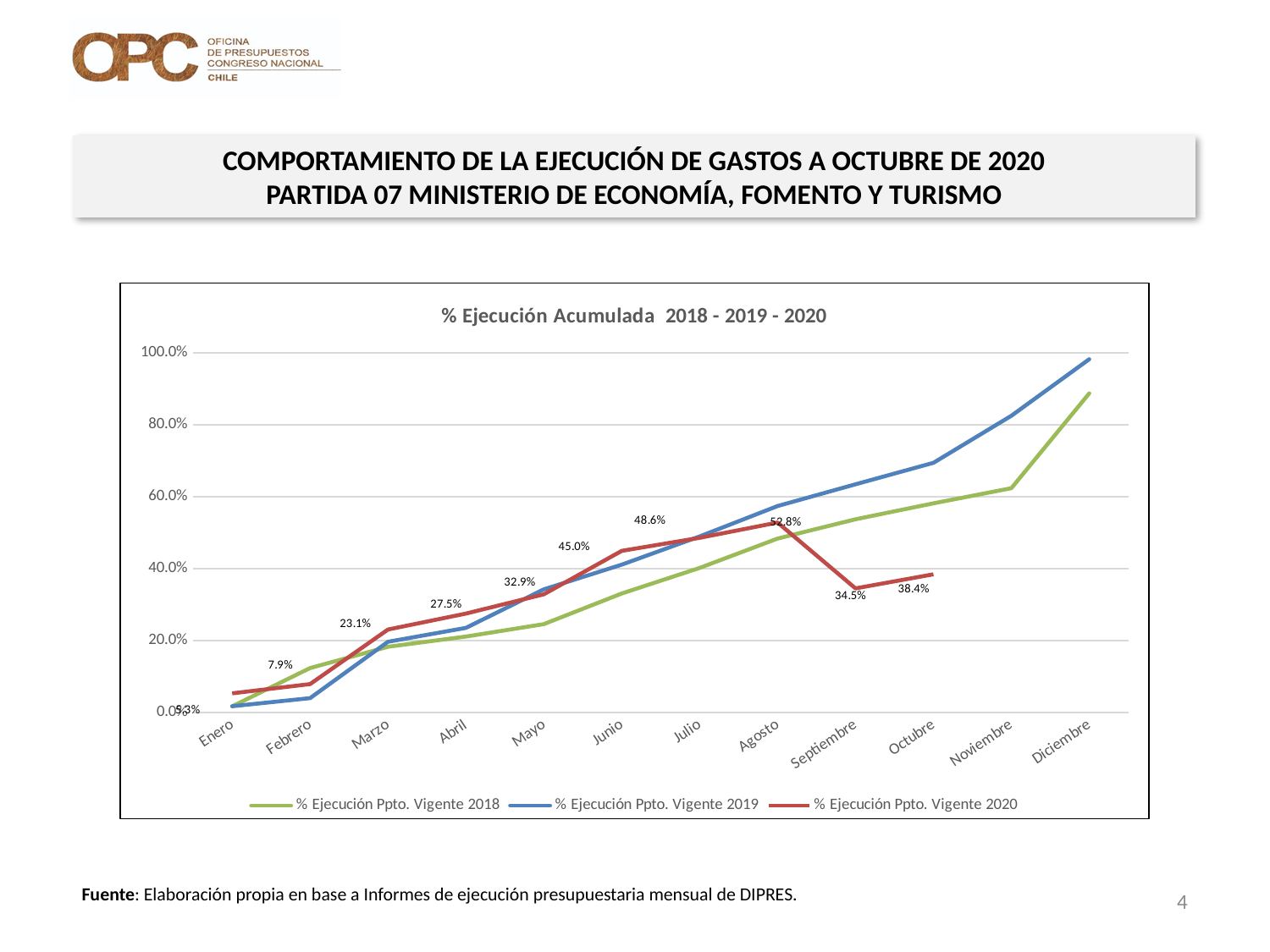
What type of chart is shown on the slide? line chart How many months are shown on the x axis? 12 What is the value for % Ejecución Ppto. Vigente 2020 in Febrero? 7.9% What is the difference between the % Ejecución Ppto. Vigente 2020 values for Agosto and Septiembre? 18.3% What is the value for % Ejecución Ppto. Vigente 2020 in Octubre? 38.4% What is the value for % Ejecución Ppto. Vigente 2020 in Junio? 45.0% Which month has the highest value for % Ejecución Ppto. Vigente 2020? Agosto Which series is higher in Diciembre, % Ejecución Ppto. Vigente 2018 or % Ejecución Ppto. Vigente 2019? % Ejecución Ppto. Vigente 2019 How many series does the legend list? 3 What is the value for % Ejecución Ppto. Vigente 2020 in Marzo? 23.1% What is the title of the chart? % Ejecución Acumulada 2018 - 2019 - 2020 Is the value for % Ejecución Ppto. Vigente 2019 in Diciembre greater or less than 80.0%? greater